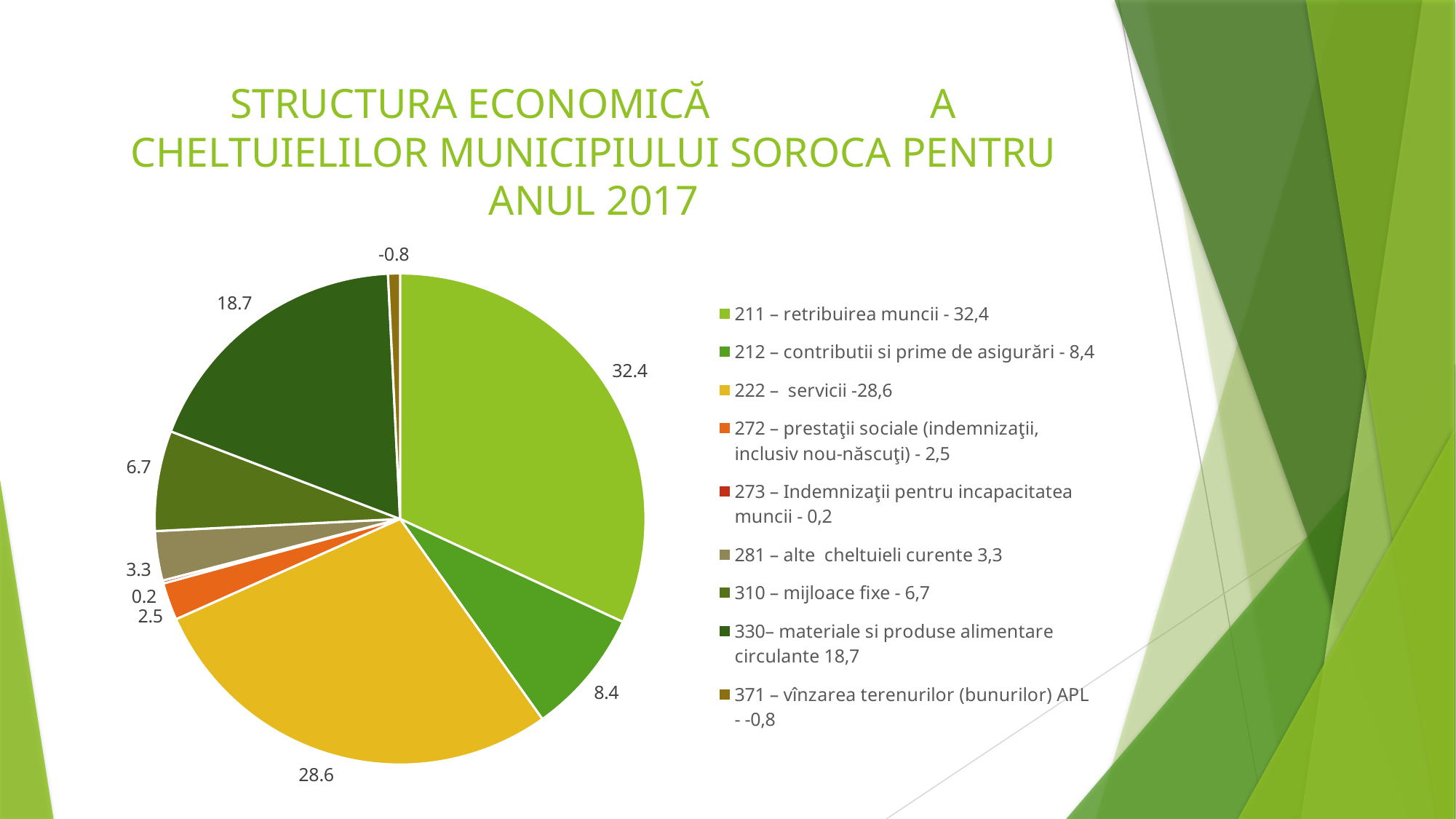
What value is shown for the slice "272 – prestaţii sociale (indemnizaţii, inclusiv nou-născuţi)"? 2.5 How many categories does the legend of the pie chart list? 9 Which is larger: the value for "212 – contributii si prime de asigurări" or the value for "310 – mijloace fixe"? 212 – contributii si prime de asigurări What value is shown for the slice "330 – materiale si produse alimentare circulante"? 18.7 Which category has the largest slice of the pie? 211 – retribuirea muncii Which category has the smallest value in the pie chart? 371 – vînzarea terenurilor (bunurilor) APL What kind of chart is shown on the slide? pie chart What is the difference between the values for "211 – retribuirea muncii" and "222 – servicii"? 3.8 What value is shown for the slice "211 – retribuirea muncii"? 32.4 What is the difference between the values for "330 – materiale si produse alimentare circulante" and "212 – contributii si prime de asigurări"? 10.3 What value is shown for the slice "222 – servicii"? 28.6 What year does the chart title say the expenditure structure refers to? 2017